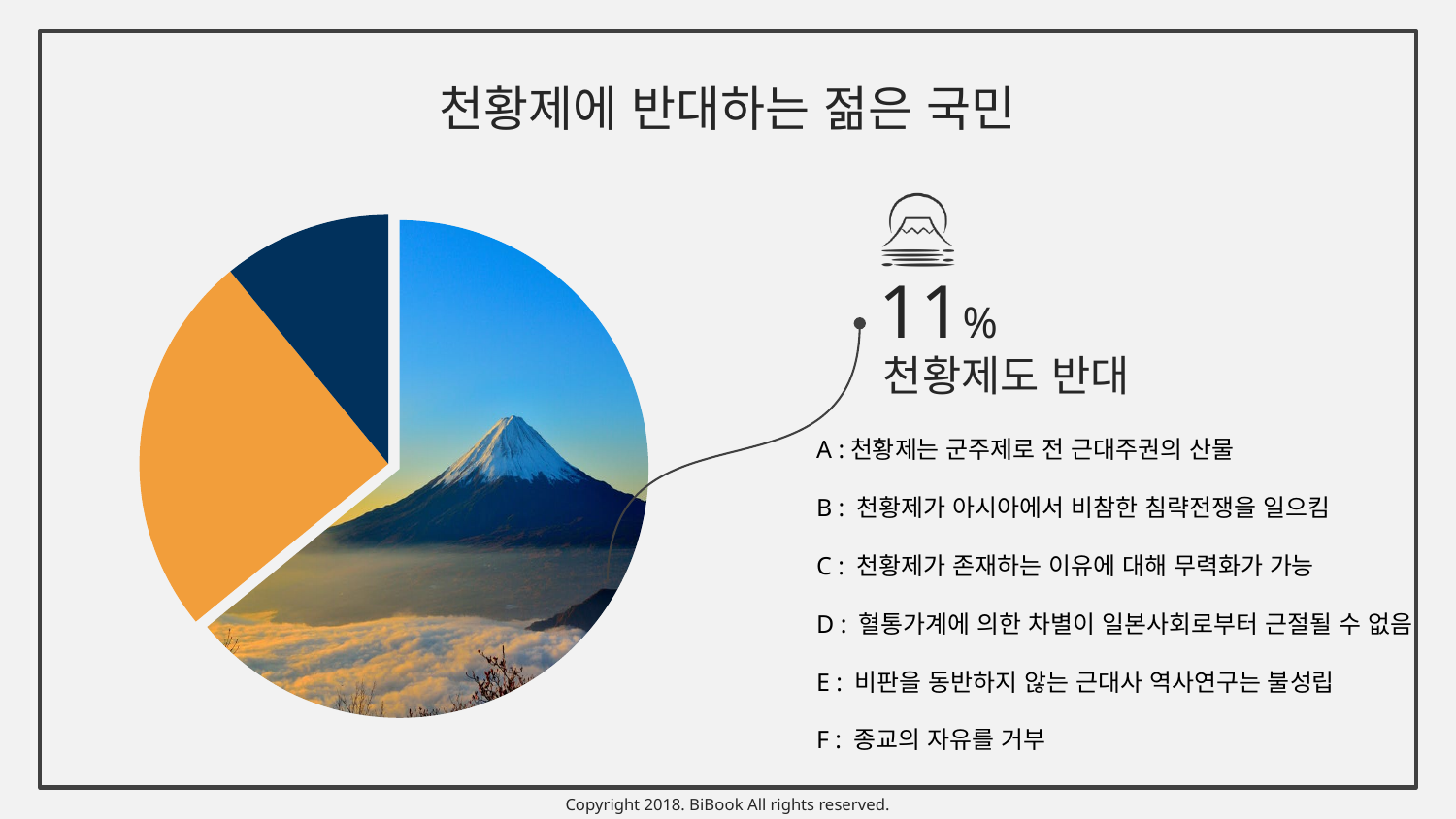
Which slice is larger, the orange slice or the dark navy slice? the orange slice What percentage value is printed next to the pie chart? 11% What is the title of the slide containing the pie chart? 천황제에 반대하는 젊은 국민 Which slice is larger, the photo-filled slice or the orange slice? the photo-filled slice What label accompanies the 11% figure next to the pie chart? 천황제도 반대 How many slices does the pie chart have? 3 Which slice of the pie chart is the largest: the photo-filled slice, the orange slice, or the dark navy slice? the photo-filled slice Which slice of the pie chart is the smallest: the photo-filled slice, the orange slice, or the dark navy slice? the dark navy slice What kind of chart is shown on the slide? pie chart